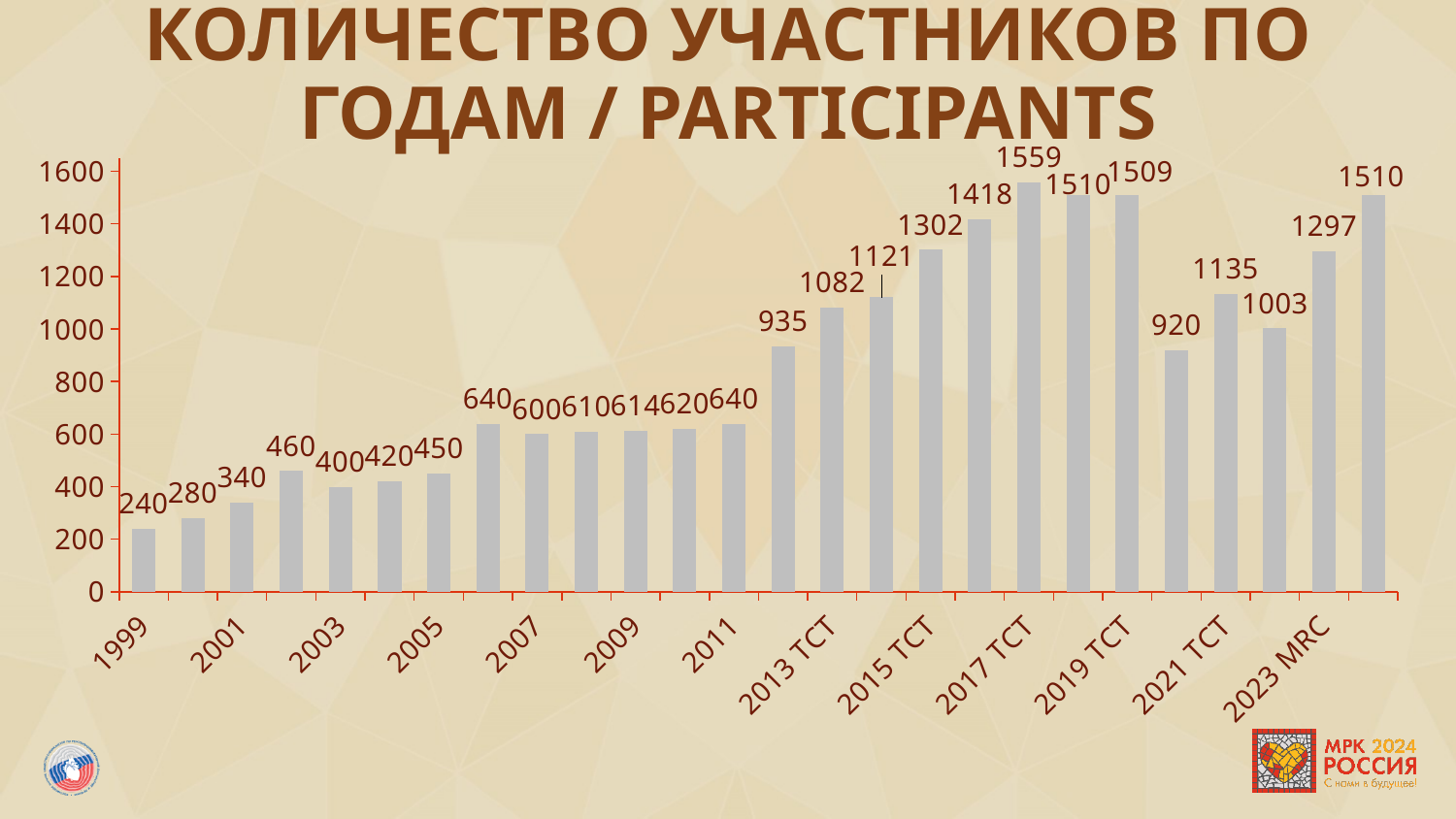
Which category has the highest value? 2017 TCT What is the difference between the values for 2015 TCT and 2013 TCT? 220 What is the value for 2021 TCT? 1135 What is the value for 2023 MRC? 1297 Is the value for 2011 greater or less than 800? less What is the title of the chart? КОЛИЧЕСТВО УЧАСТНИКОВ ПО ГОДАМ / PARTICIPANTS Which category has the lowest value? 1999 How many bars are plotted in the chart? 26 Which is larger, the value for 2019 TCT or the value for 2021 TCT? 2019 TCT What is the value for 1999? 240 What kind of chart is shown on the slide? bar chart What is the value for 2017 TCT? 1559